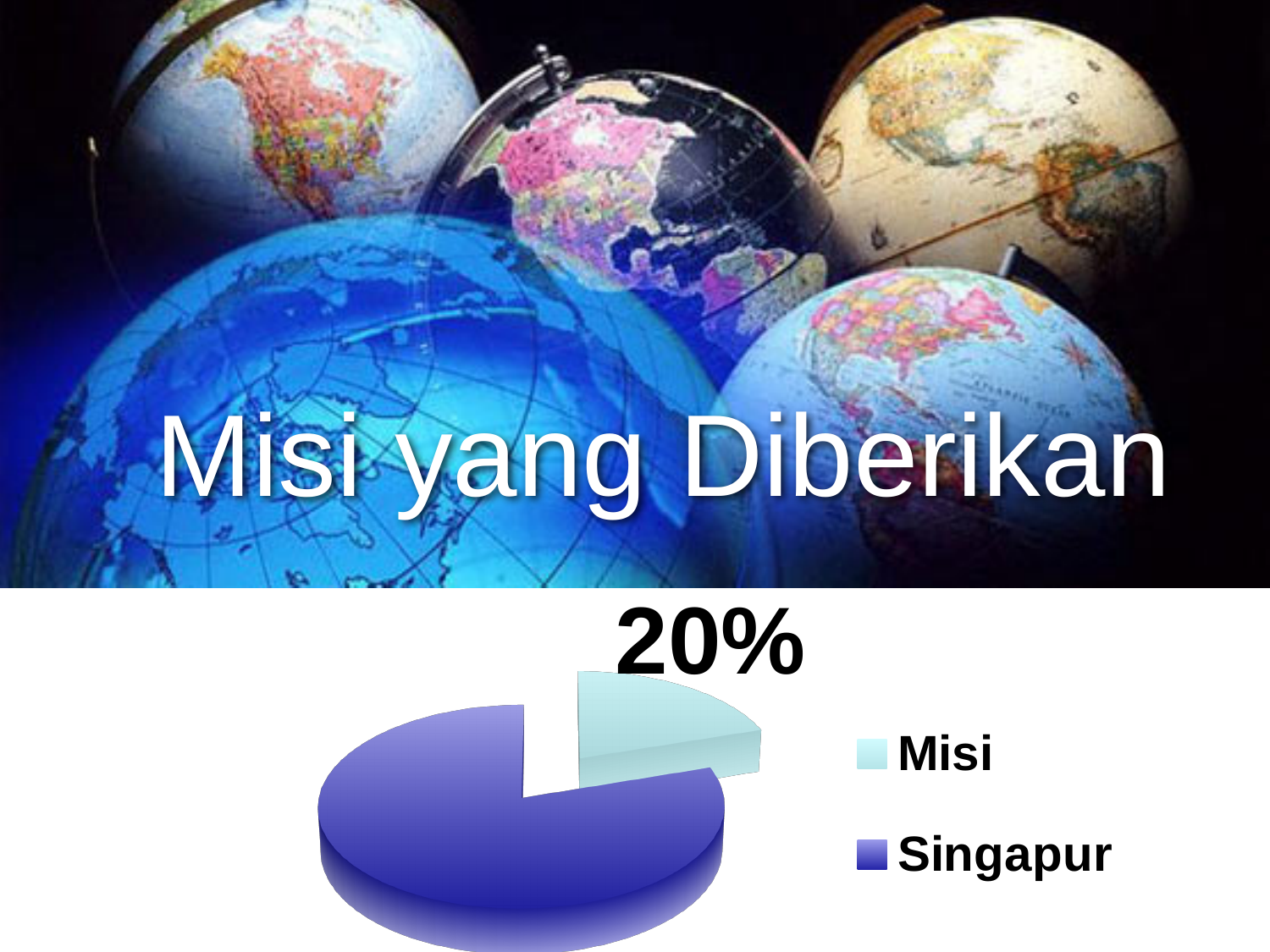
How many entries does the legend list? 2 What is the title shown on the slide above the chart? Misi yang Diberikan What kind of chart is shown on the slide? pie chart What value is printed as the data label on the pie chart? 20% Is the share for Misi greater or less than 50%? less How many slices does the pie chart have? 2 Which legend entry is shown in dark blue? Singapur Which slice of the pie chart is the smallest? Misi Which slice of the pie chart is the largest? Singapur Is the share for Singapur greater or less than 50%? greater What share of the pie does the Misi slice represent? 20% Which is larger, the Misi slice or the Singapur slice? Singapur